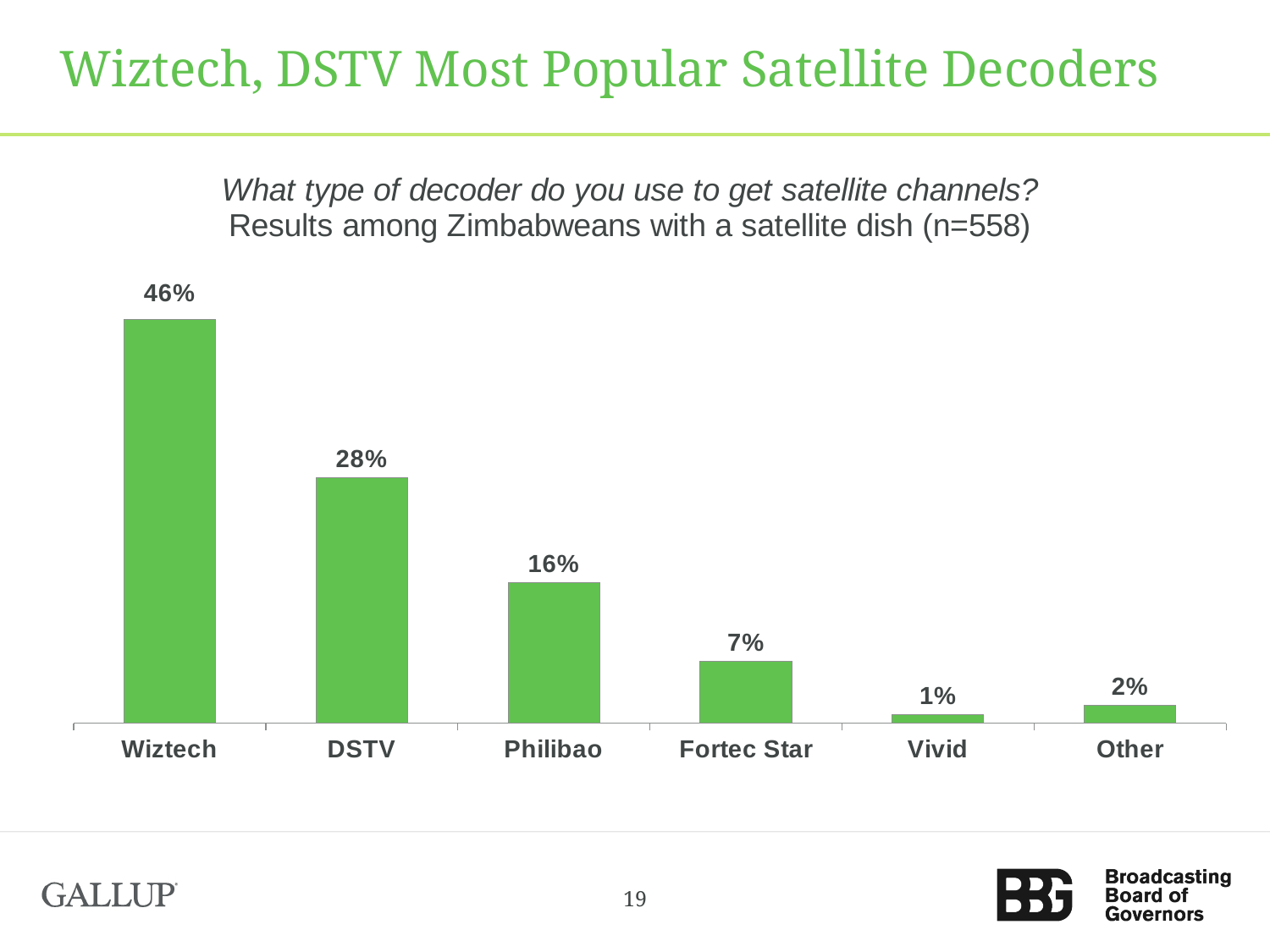
What is the value shown for DSTV? 28% What is the value shown for Fortec Star? 7% How many decoder categories are shown on the chart? 6 What is the sample size (n) stated in the chart subtitle? 558 What is the value shown for Vivid? 1% What kind of chart is shown on the slide? Bar chart Which decoder type has the lowest value? Vivid Which decoder type has the highest value? Wiztech What percentage of respondents use a Philibao decoder? 16% What percentage of respondents use a Wiztech decoder? 46% Which is larger, the value for Philibao or the value for Fortec Star? Philibao What is the difference in percentage points between Wiztech and DSTV? 18